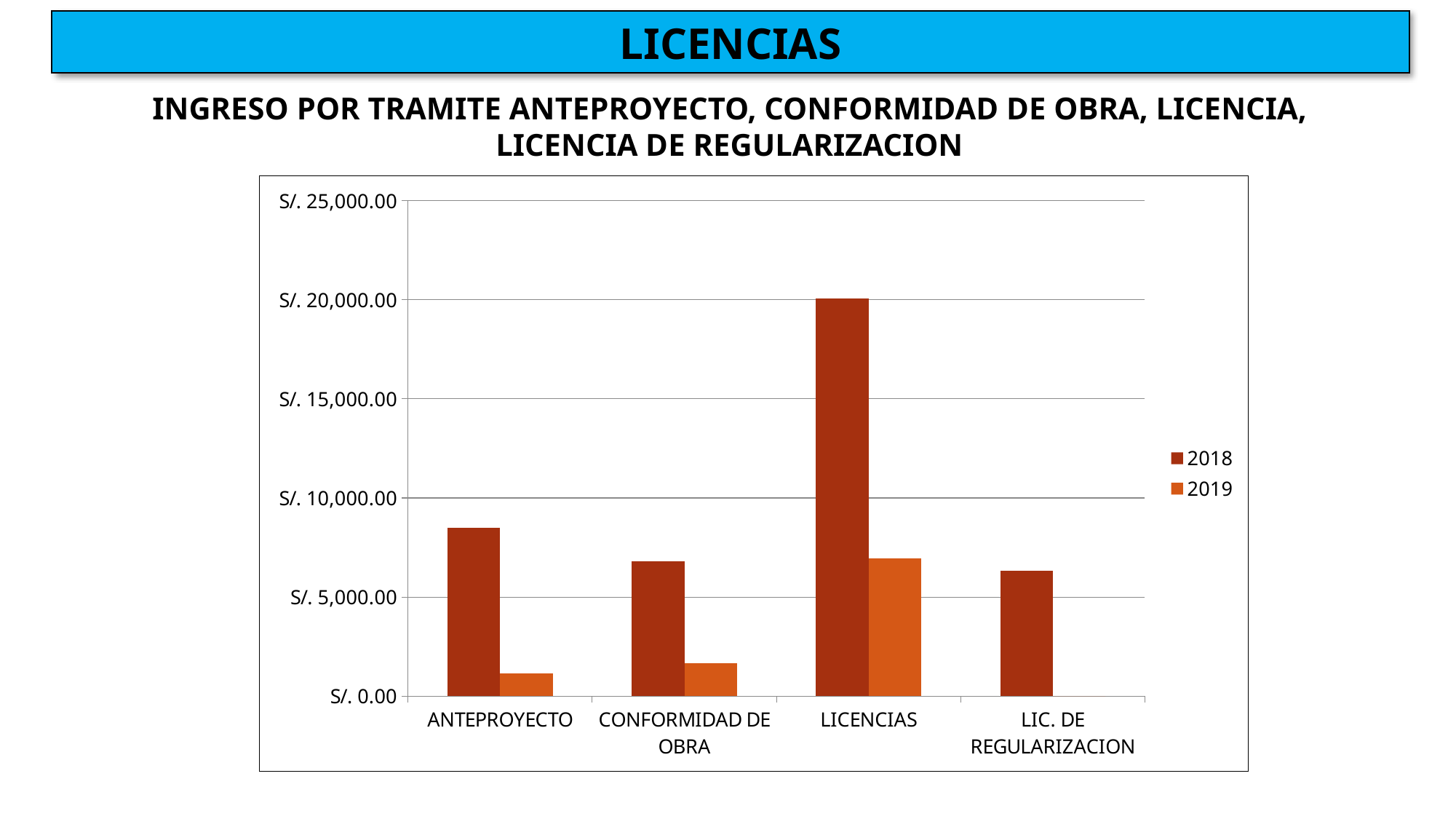
Which category has the highest value for the 2018 series? LICENCIAS How many categories are shown on the x axis of the chart? 4 How many series does the chart's legend list? 2 Is the 2018 value for LICENCIAS greater or less than S/. 15,000.00? greater What are the two entries listed in the chart's legend? 2018 and 2019 For LICENCIAS, which series has the larger value: 2018 or 2019? 2018 Is the 2019 value for CONFORMIDAD DE OBRA greater or less than S/. 5,000.00? less What kind of chart is shown on the slide? bar chart Which category has the highest value for the 2019 series? LICENCIAS Which is larger for 2018: ANTEPROYECTO or CONFORMIDAD DE OBRA? ANTEPROYECTO Is the 2019 value for LICENCIAS greater or less than S/. 10,000.00? less